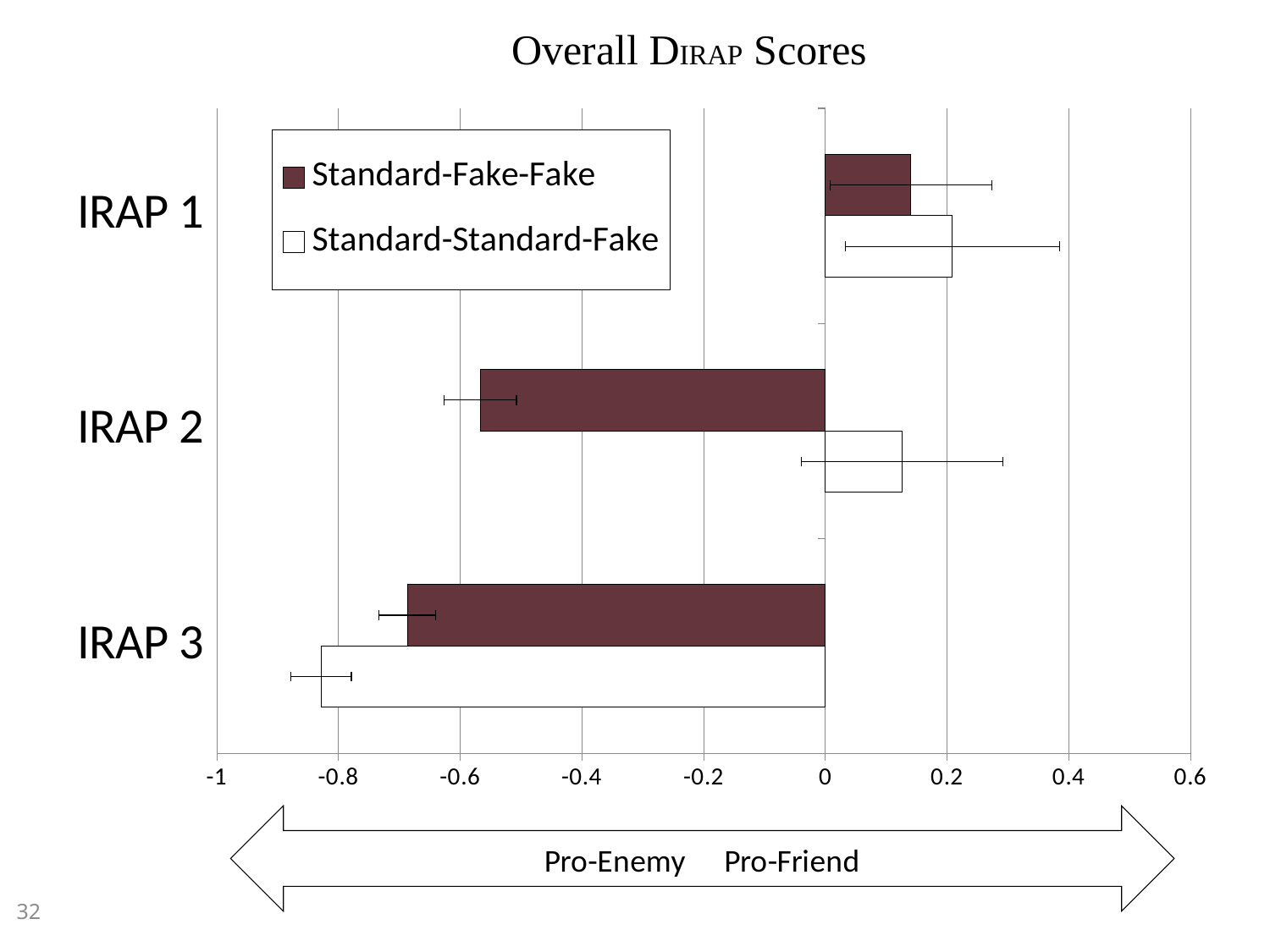
Which series is shown with dark filled bars? Standard-Fake-Fake For which IRAP is the Standard-Standard-Fake value lowest? IRAP 3 What is the title of the chart? Overall DIRAP Scores How many series does the legend list? 2 Is the Standard-Fake-Fake value for IRAP 3 greater or less than -0.6? less What kind of chart is shown on the slide? bar chart How many IRAP categories are plotted on the chart? 3 Is the Standard-Fake-Fake value for IRAP 1 greater or less than 0.2? less For IRAP 2, which series has the larger value, Standard-Fake-Fake or Standard-Standard-Fake? Standard-Standard-Fake Is the Standard-Fake-Fake value for IRAP 2 greater or less than -0.6? greater For which IRAP is the Standard-Fake-Fake value highest? IRAP 1